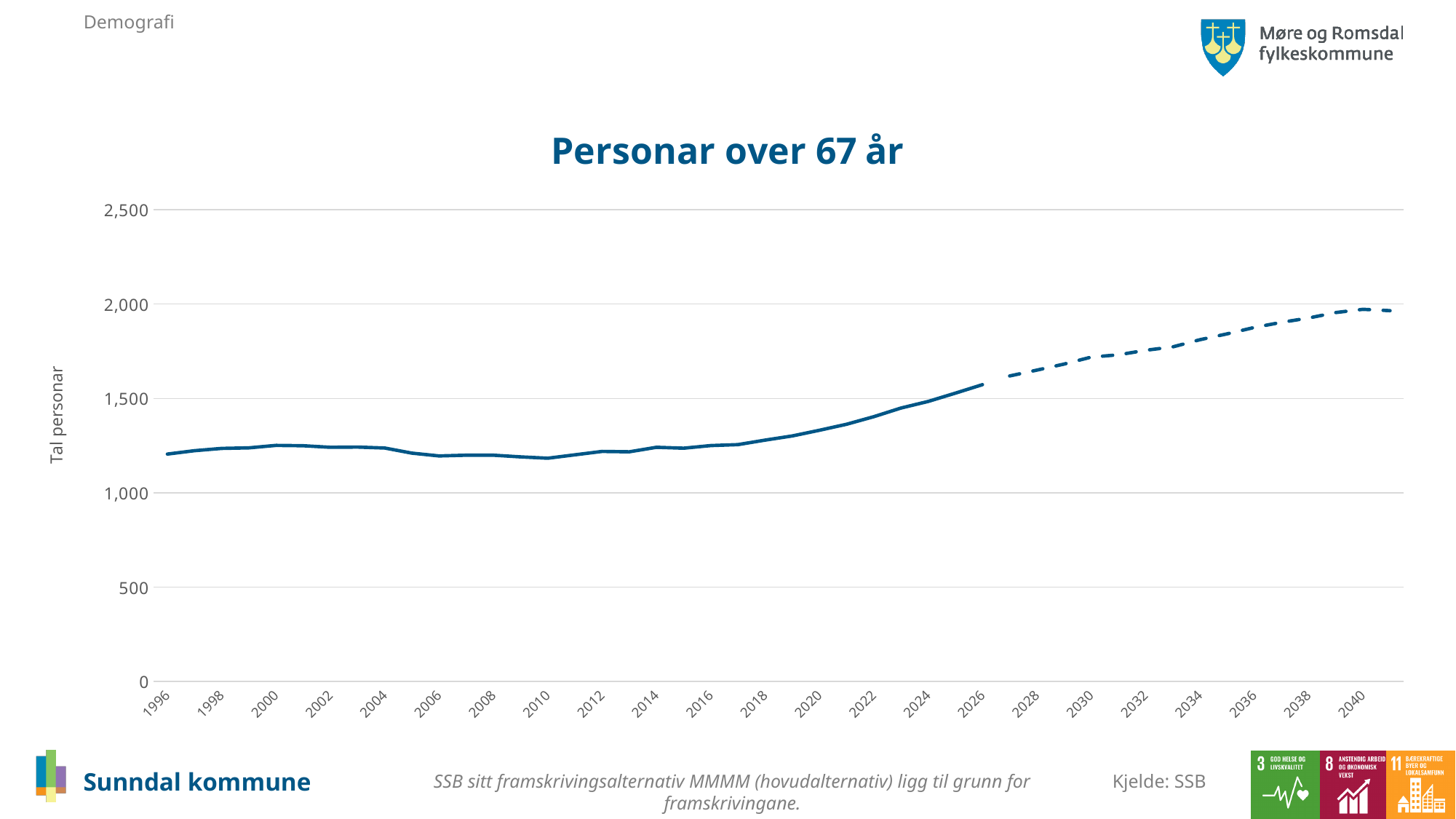
What is the label on the vertical axis of the chart? Tal personar Do the values rise or fall between 2018 and 2026? rise Is the value for 2020 greater or less than 1,500? less Is the value for 1996 greater or less than 1,000? greater Is the value for 2026 greater or less than 1,500? greater What is the title of the chart? Personar over 67 år What kind of chart is shown on the slide? line chart Is the value for 2040 larger or smaller than the value for 1996? larger Do the values rise or fall between 2026 and 2040? rise